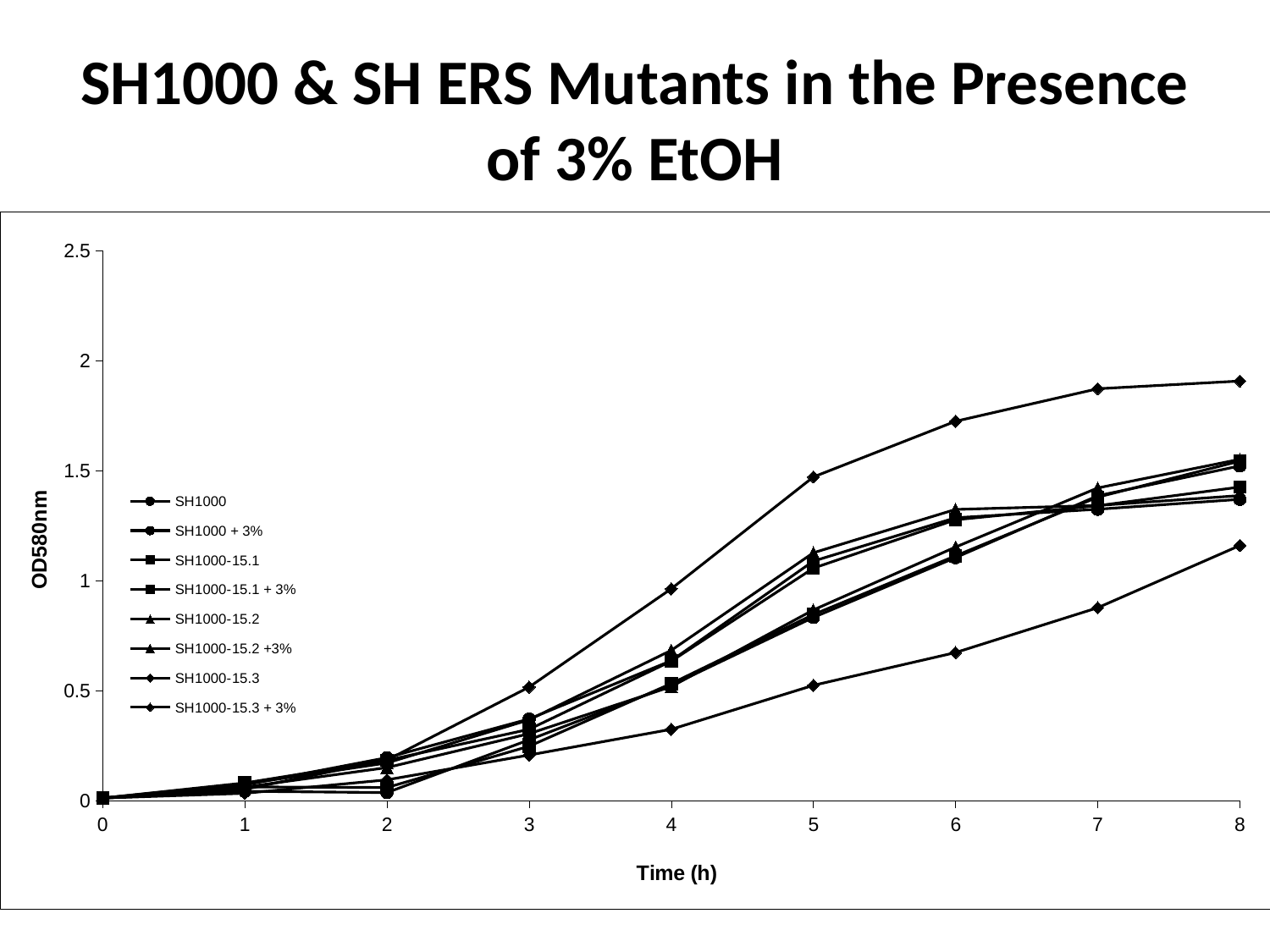
What kind of chart is shown on the slide? line chart Are all plotted values at 1 h greater or less than 0.5? less Is the highest plotted value at 8 h greater or less than 1.5? greater Do the plotted OD580nm values generally rise or fall as time increases from 0 to 8 h? rise How many time points are marked along the x axis? 9 How many series does the legend list? 8 Is the lowest plotted value at 8 h greater or less than 1.5? less What is the label of the y axis? OD580nm What is the label of the x axis? Time (h)